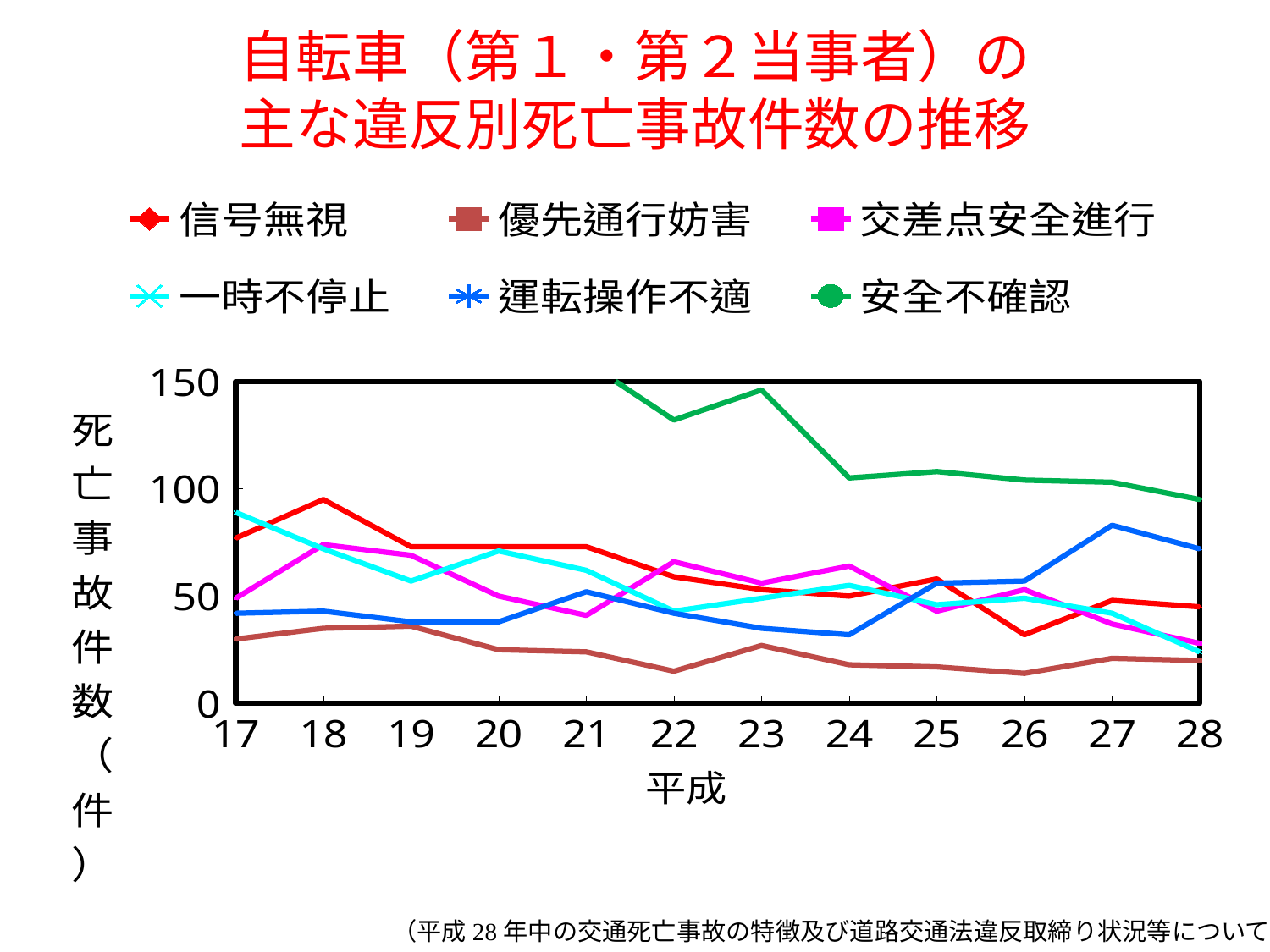
In 平成27, which is larger: 運転操作不適 or 信号無視? 運転操作不適 Is the value for 優先通行妨害 in 平成22 greater or less than 50? less Is the value for 運転操作不適 in 平成27 greater or less than 50? greater Does the value for 安全不確認 rise or fall from 平成23 to 平成28? fall Which series has the highest value in 平成28? 安全不確認 Which series has the lowest value in 平成28? 優先通行妨害 Is the value for 安全不確認 in 平成23 greater or less than 100? greater How many series does the legend list? 6 How many years are shown along the x axis? 12 What is the label on the x axis? 平成 What kind of chart is shown on the slide? line chart